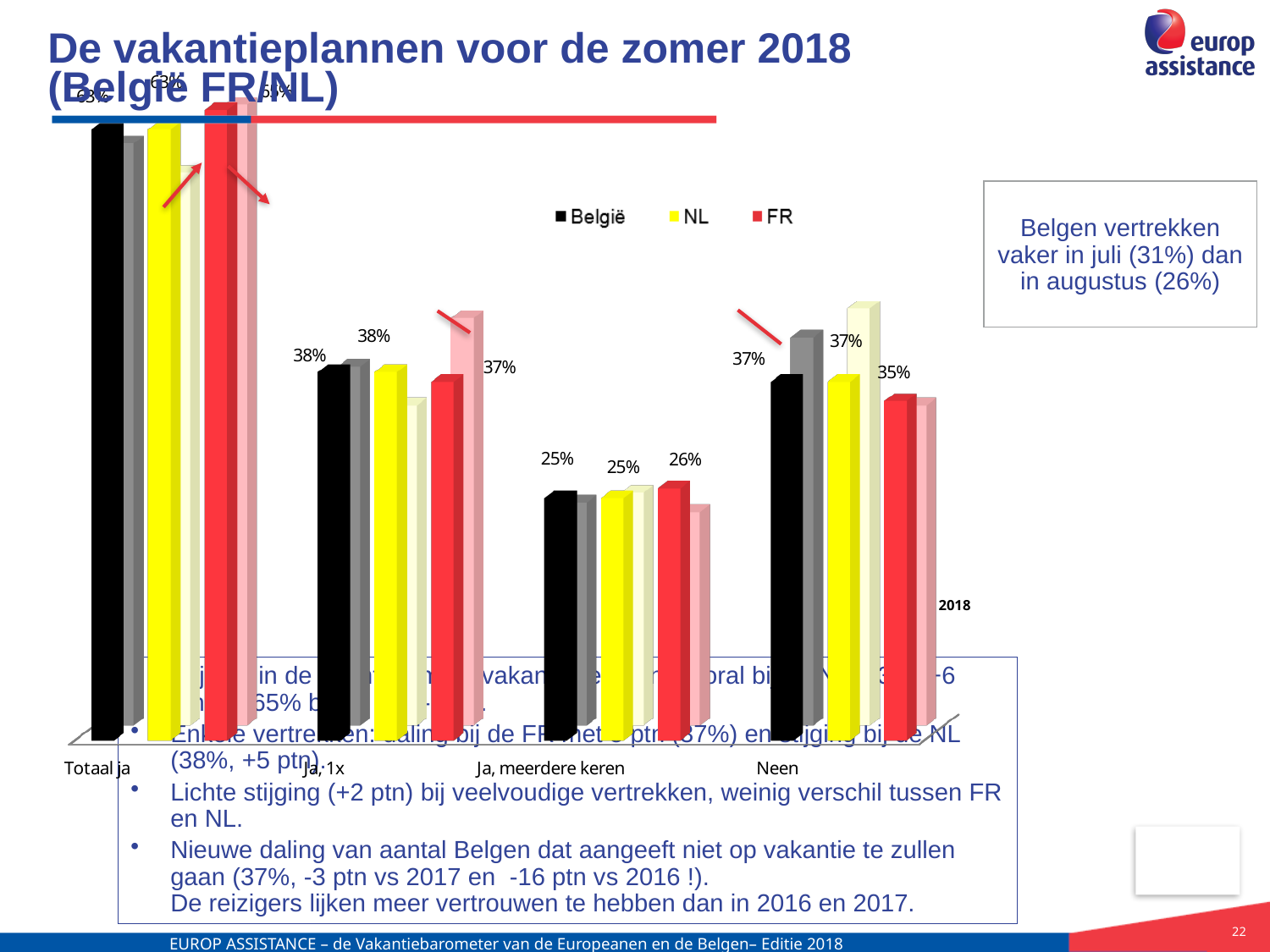
How many series does the chart legend list? 3 What is the value for FR in the category 'Neen'? 35% What is the value for NL in the category 'Neen'? 37% What is the value for FR in the category 'Ja, meerdere keren'? 26% In the category 'Ja, meerdere keren', which is larger: the value for FR or the value for België? FR How many categories are shown along the x axis of the chart? 4 What is the value for FR in the category 'Ja, 1x'? 37% Which category has the lowest value for België? Ja, meerdere keren What is the difference between the België value (37%) and the FR value (35%) in the category 'Neen'? 2 percentage points What kind of chart is shown on the slide? Bar chart What is the value for België in the category 'Ja, 1x'? 38% Which colour represents the series 'FR' in the chart legend? Red